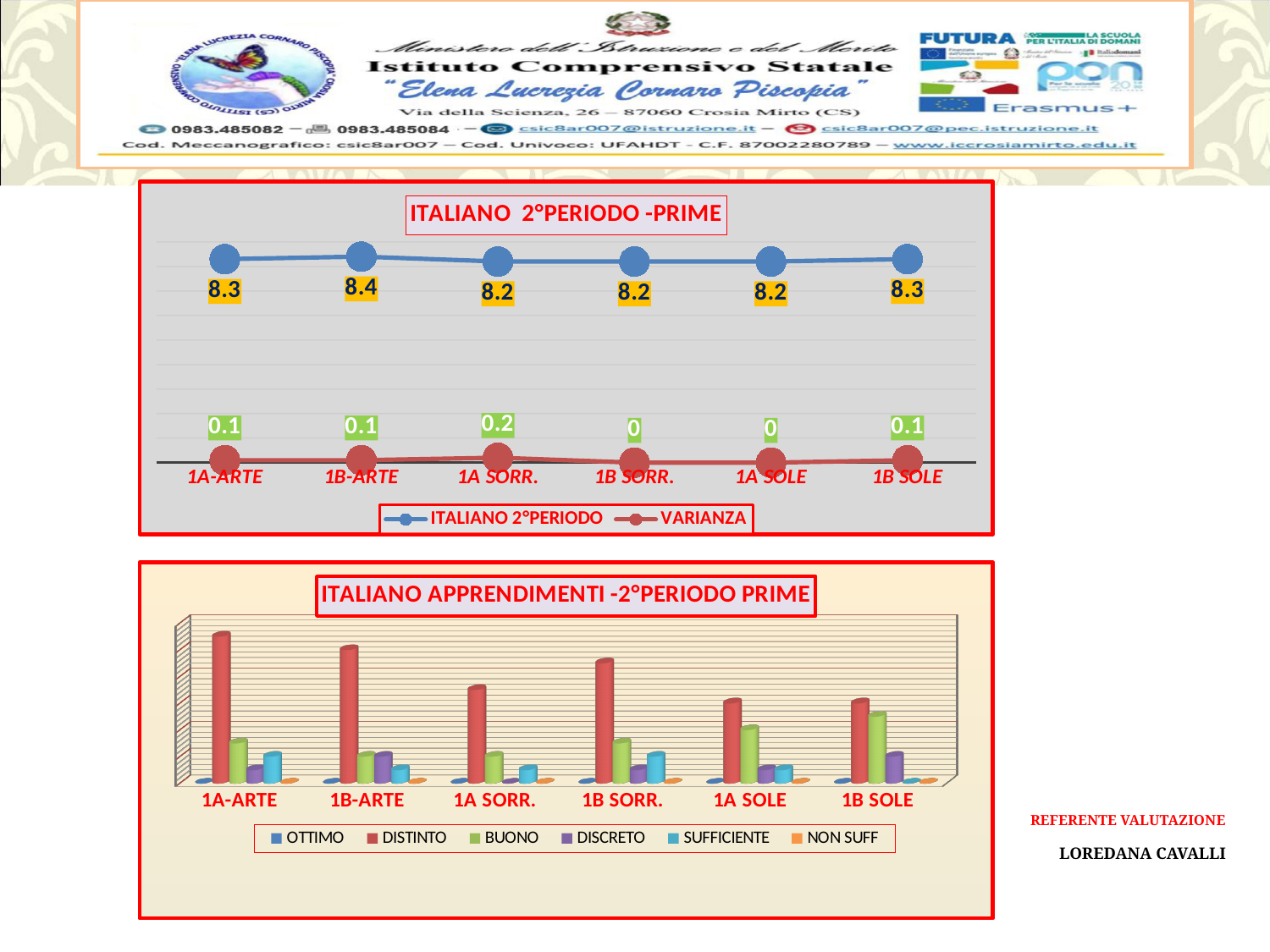
In the chart titled "ITALIANO 2°PERIODO -PRIME", what is the ITALIANO 2°PERIODO value for 1B-ARTE? 8.4 In the chart titled "ITALIANO 2°PERIODO -PRIME", which class has the highest VARIANZA value? 1A SORR. In the chart titled "ITALIANO 2°PERIODO -PRIME", how many classes are shown on the x axis? 6 In the chart titled "ITALIANO APPRENDIMENTI -2°PERIODO PRIME", which series has the tallest bar for 1A-ARTE? DISTINTO In the chart titled "ITALIANO APPRENDIMENTI -2°PERIODO PRIME", is the BUONO bar for 1B SOLE taller or shorter than the BUONO bar for 1A SORR.? Taller In the chart titled "ITALIANO 2°PERIODO -PRIME", which class has the highest ITALIANO 2°PERIODO value? 1B-ARTE In the chart titled "ITALIANO 2°PERIODO -PRIME", what is the VARIANZA value for 1A SORR.? 0.2 In the chart titled "ITALIANO APPRENDIMENTI -2°PERIODO PRIME", how many series does the legend list? 6 What kind of chart is the one titled "ITALIANO APPRENDIMENTI -2°PERIODO PRIME"? Bar chart In the chart titled "ITALIANO 2°PERIODO -PRIME", what is the difference between the ITALIANO 2°PERIODO values for 1B-ARTE and 1A SORR.? 0.2 In the chart titled "ITALIANO 2°PERIODO -PRIME", how many series does the legend list? 2 In the chart titled "ITALIANO 2°PERIODO -PRIME", which classes have a VARIANZA value of 0? 1B SORR. and 1A SOLE